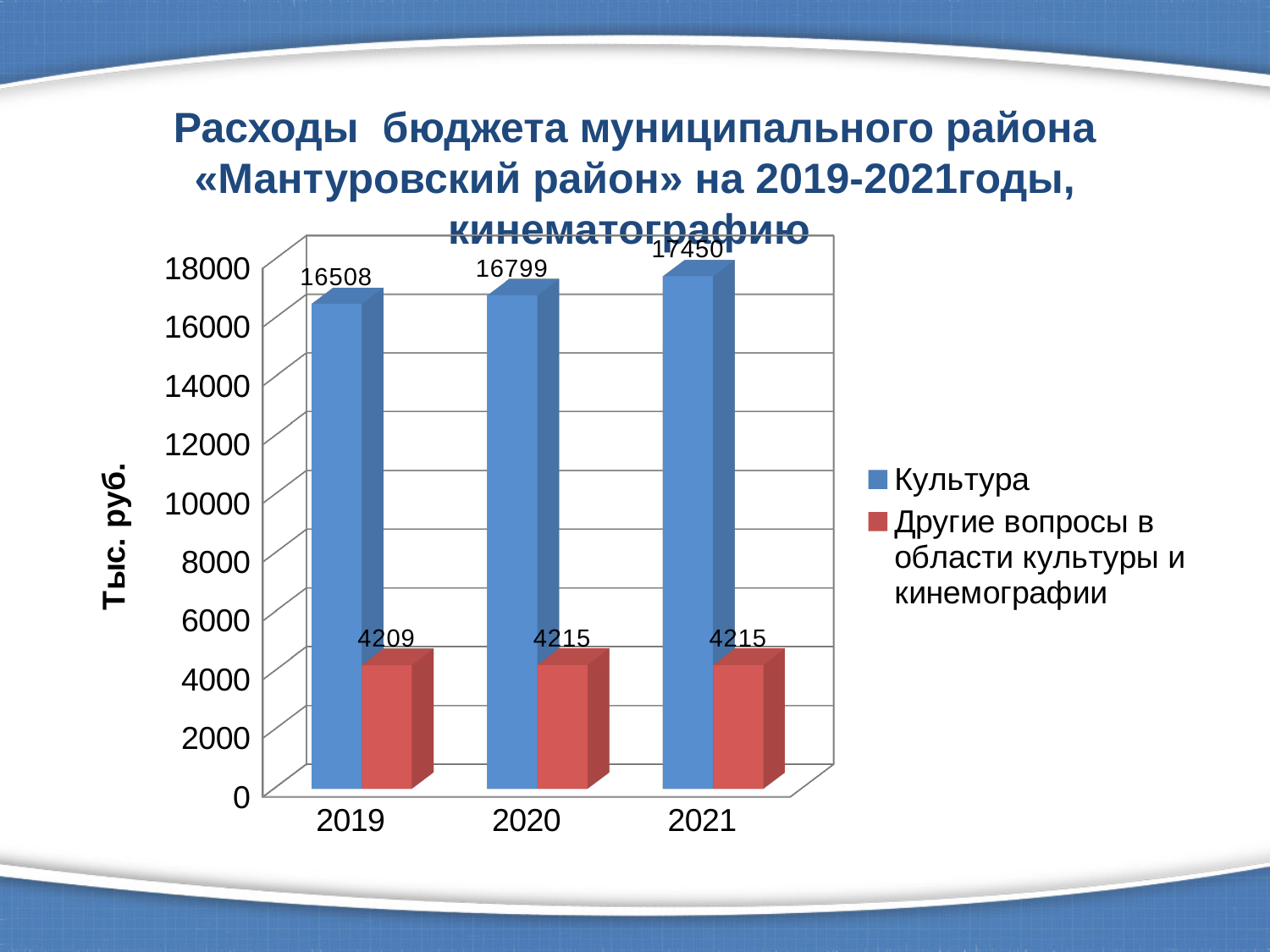
In which year is the value for Культура lowest? 2019 How many series does the legend list? 2 Which is larger in 2021: Культура or Другие вопросы в области культуры и кинемографии? Культура In which year is the value for Культура highest? 2021 How many years are shown on the x axis? 3 What is the value for Другие вопросы в области культуры и кинемографии in 2020? 4215 What is the value for Культура in 2021? 17450 What is the value for Культура in 2019? 16508 Does the value for Культура rise or fall from 2019 to 2021? rise What is the difference between the Культура values for 2021 and 2019? 942 What is the value for Другие вопросы в области культуры и кинемографии in 2019? 4209 What is the difference between the Культура and Другие вопросы в области культуры и кинемографии values in 2020? 12584